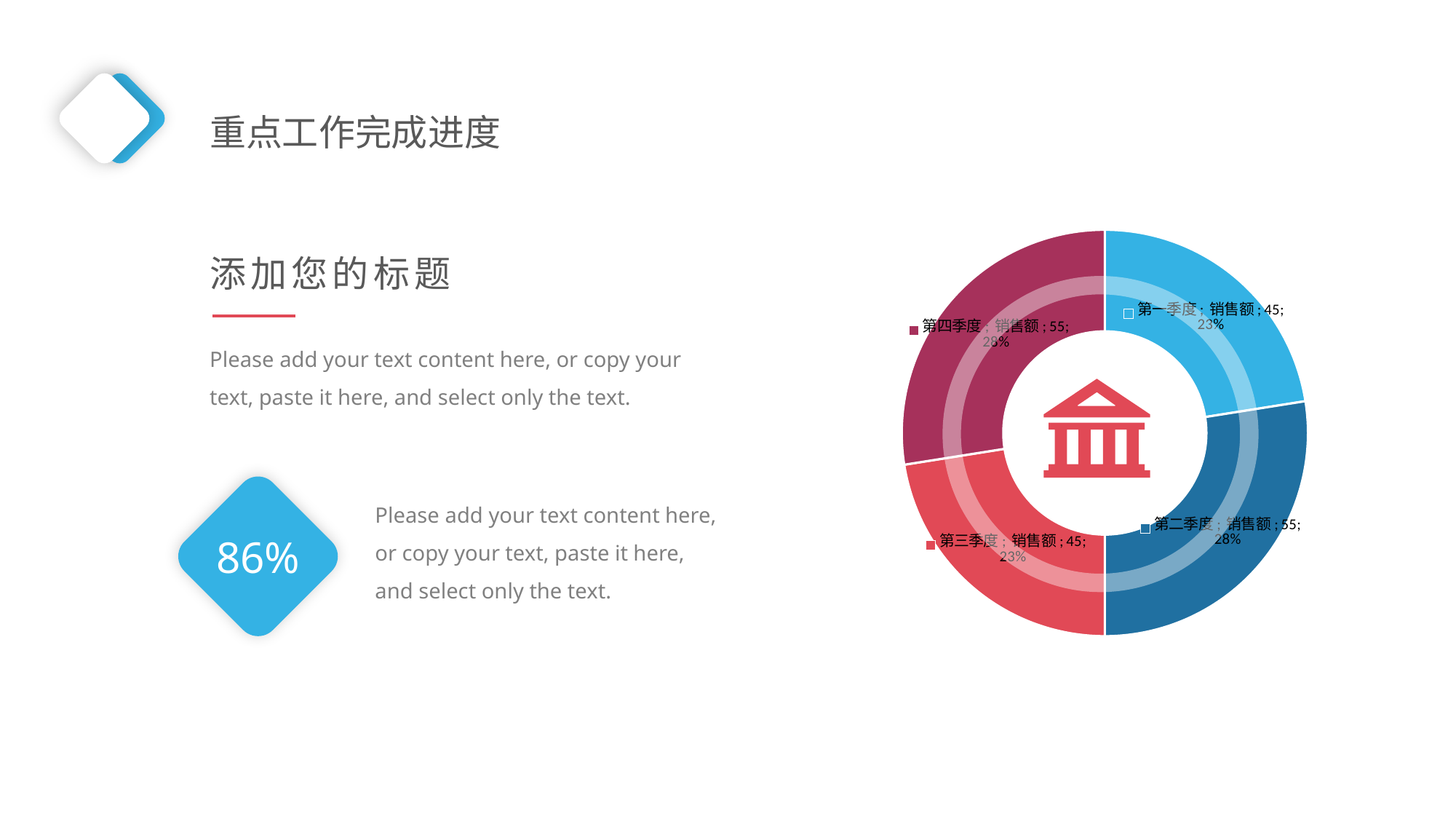
What is the difference between the 销售额 values for 第四季度 and 第三季度 in the doughnut chart? 10 What is the 销售额 value for 第二季度 in the doughnut chart? 55 What is the 销售额 value for 第三季度 in the doughnut chart? 45 What percentage share does 第二季度 have in the doughnut chart? 28% Which is larger in the doughnut chart, the value for 第一季度 or the value for 第二季度? 第二季度 What kind of chart is shown on the slide? Doughnut chart What is the 销售额 value for 第四季度 in the doughnut chart? 55 What is the 销售额 value for 第一季度 in the doughnut chart? 45 What is the name of the data series shown in the doughnut chart labels? 销售额 What percentage share does 第三季度 have in the doughnut chart? 23% What is the total of all four quarter values in the doughnut chart? 200 How many categories (quarters) are shown in the doughnut chart? 4